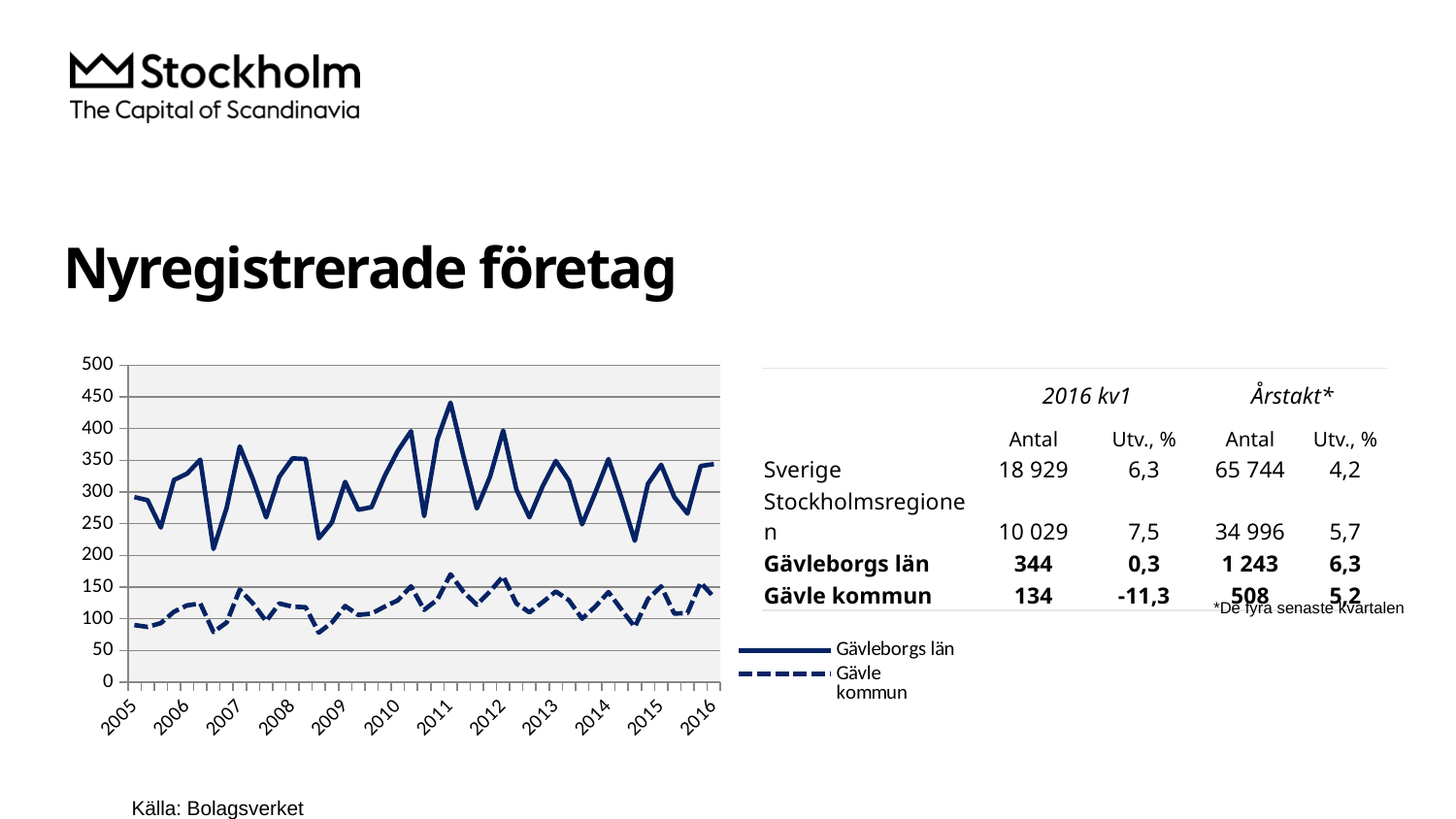
Is the highest value for Gävleborgs län in the chart greater or less than 400? greater Which series is drawn with a dashed line in the chart? Gävle kommun Is the lowest value for Gävle kommun in the chart greater or less than 100? less Is the highest value for Gävle kommun in the chart greater or less than 200? less How many years are labelled on the chart's x axis? 12 What kind of chart is shown on the slide? line chart How many series does the chart's legend list? 2 What is the first year labelled on the chart's x axis? 2005 Which two series are listed in the chart's legend? Gävleborgs län and Gävle kommun In which year does the Gävleborgs län series reach its highest peak? 2011 Which series has the higher values throughout the chart, Gävleborgs län or Gävle kommun? Gävleborgs län